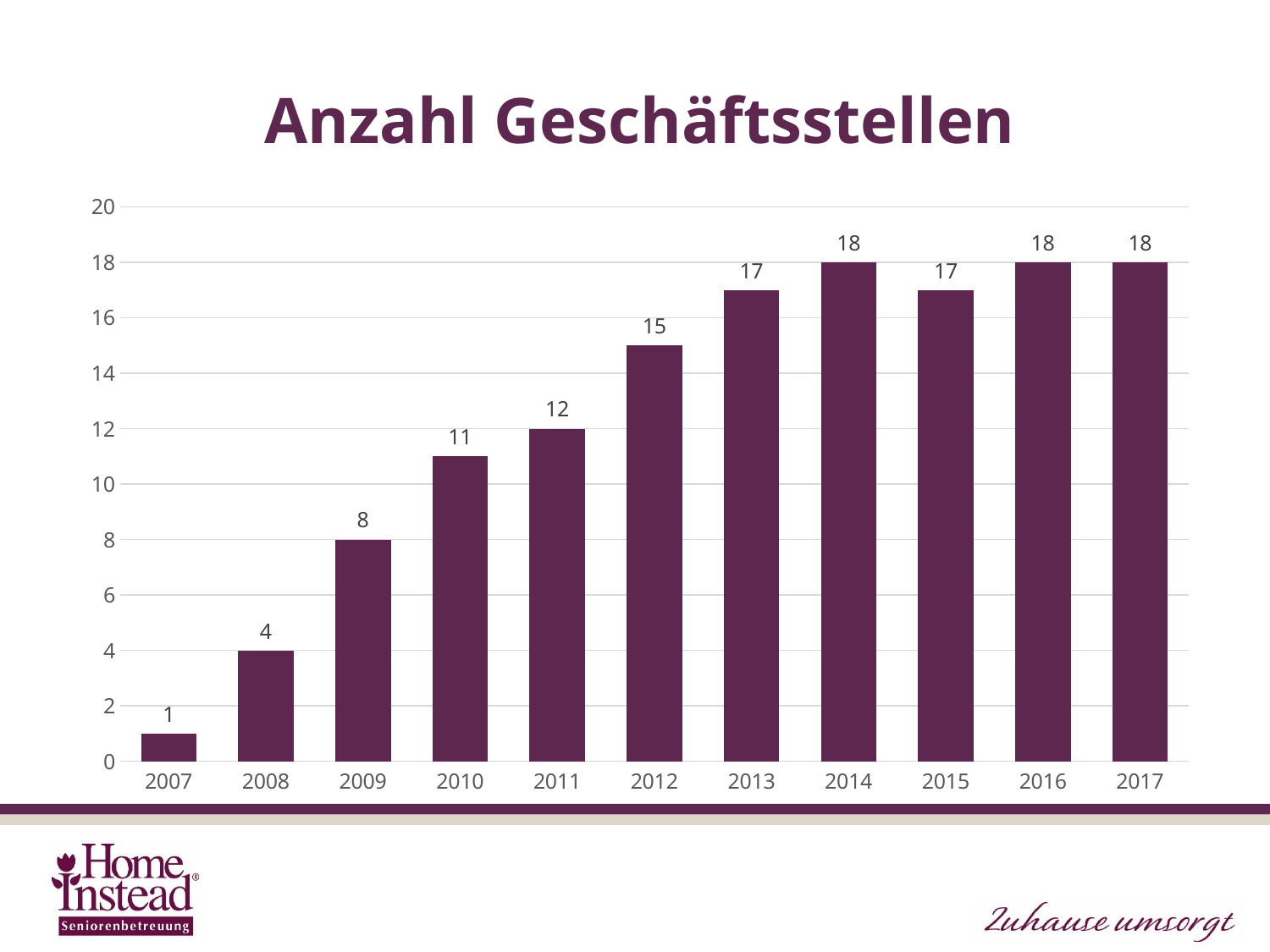
Do the values generally rise or fall from 2007 to 2014? rise What is the value for 2007? 1 What is the value for 2015? 17 What is the value for 2012? 15 Which year has the lowest value? 2007 What is the difference between the values for 2010 and 2009? 3 What is the title of the chart? Anzahl Geschäftsstellen Is the value for 2009 greater or less than 10? less How many years are shown on the x axis? 11 What is the difference between the values for 2017 and 2007? 17 Which is larger, the value for 2011 or the value for 2013? 2013 What kind of chart is shown on the slide? bar chart